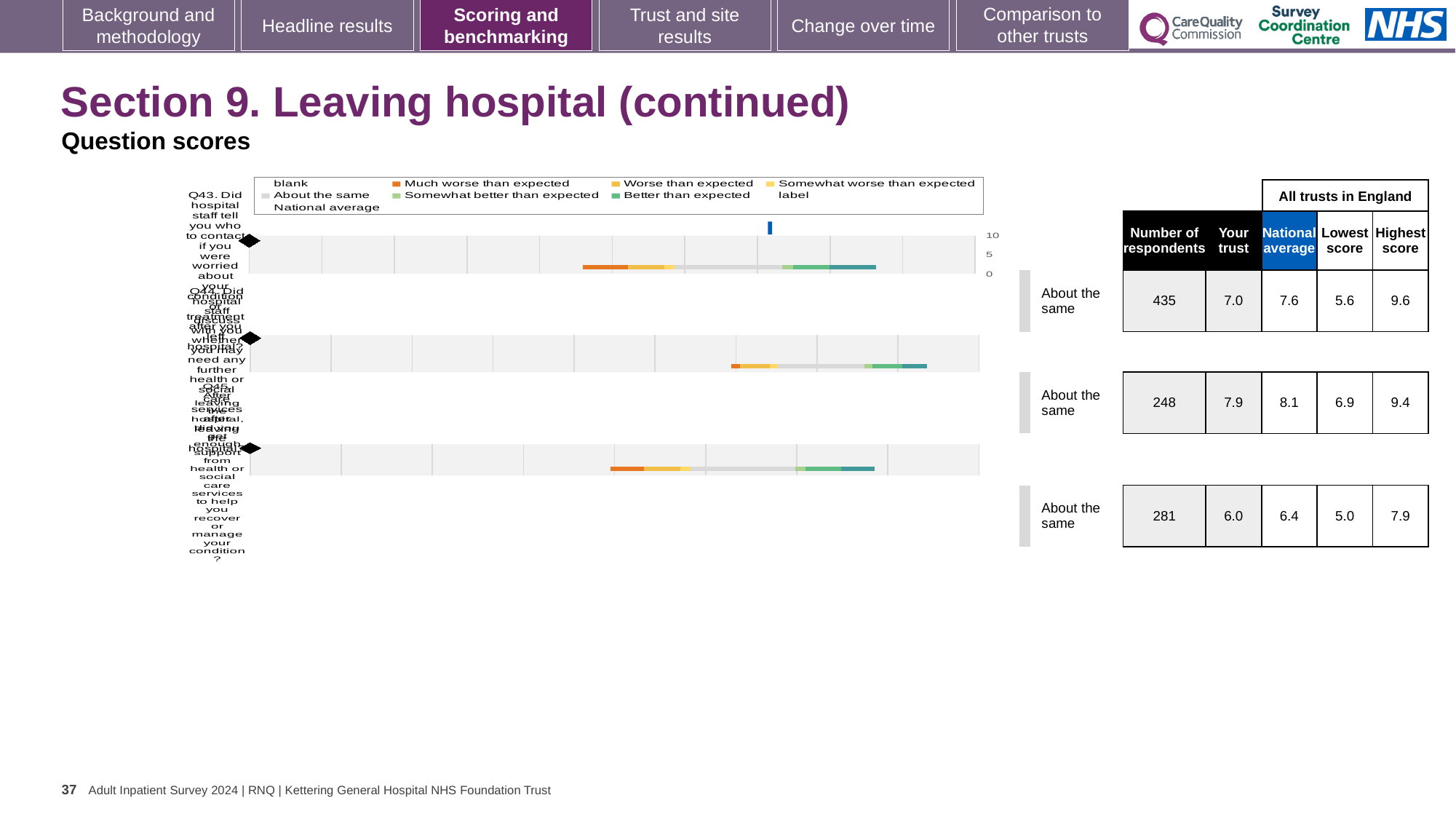
What colour represents 'Much worse than expected' in the chart legend? orange For the first question row (Q43), which is larger: the 'Your trust' score or the national average? national average How many respondents answered the second question row? 248 What is the highest score across all trusts in England for the third question row? 7.9 What is the 'Your trust' score for the first question row (Q43)? 7.0 What kind of chart is used to show the question scores on this slide? bar chart What is the national average for the first question row (Q43)? 7.6 How many question rows are plotted in the chart? 3 What is the highest tick value shown on the chart's axis? 10 Which question row has the largest number of respondents? the first row (Q43), 435 What benchmark category is shown for the third question row? About the same What is the difference between the highest score and the lowest score for the first question row (Q43)? 4.0